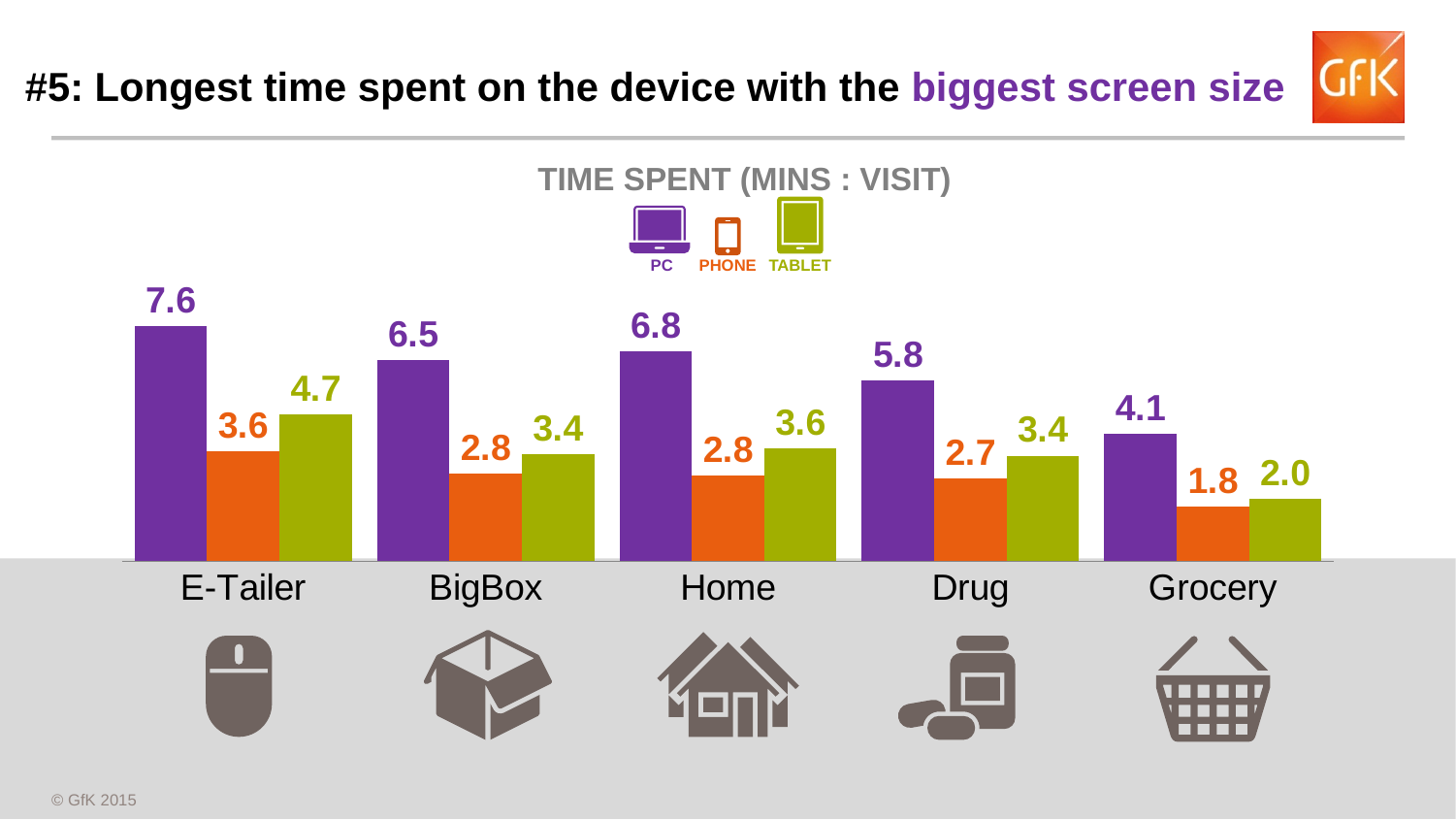
Which is larger for BigBox: Phone time spent or Tablet time spent? Tablet What is the PC time spent (mins : visit) for E-Tailer? 7.6 Which retailer category has the highest PC time spent? E-Tailer How many retailer categories are shown on the x axis? 5 What is the Phone time spent for Drug? 2.7 What kind of chart is shown on the slide? Bar chart Which colour represents the Phone series in the chart? Orange Which retailer category has the lowest Phone time spent? Grocery How many device series does the legend list? 3 What is the Tablet time spent for Grocery? 2.0 What is the difference between PC and Tablet time spent for Home? 3.2 What is the title of the chart? TIME SPENT (MINS : VISIT)